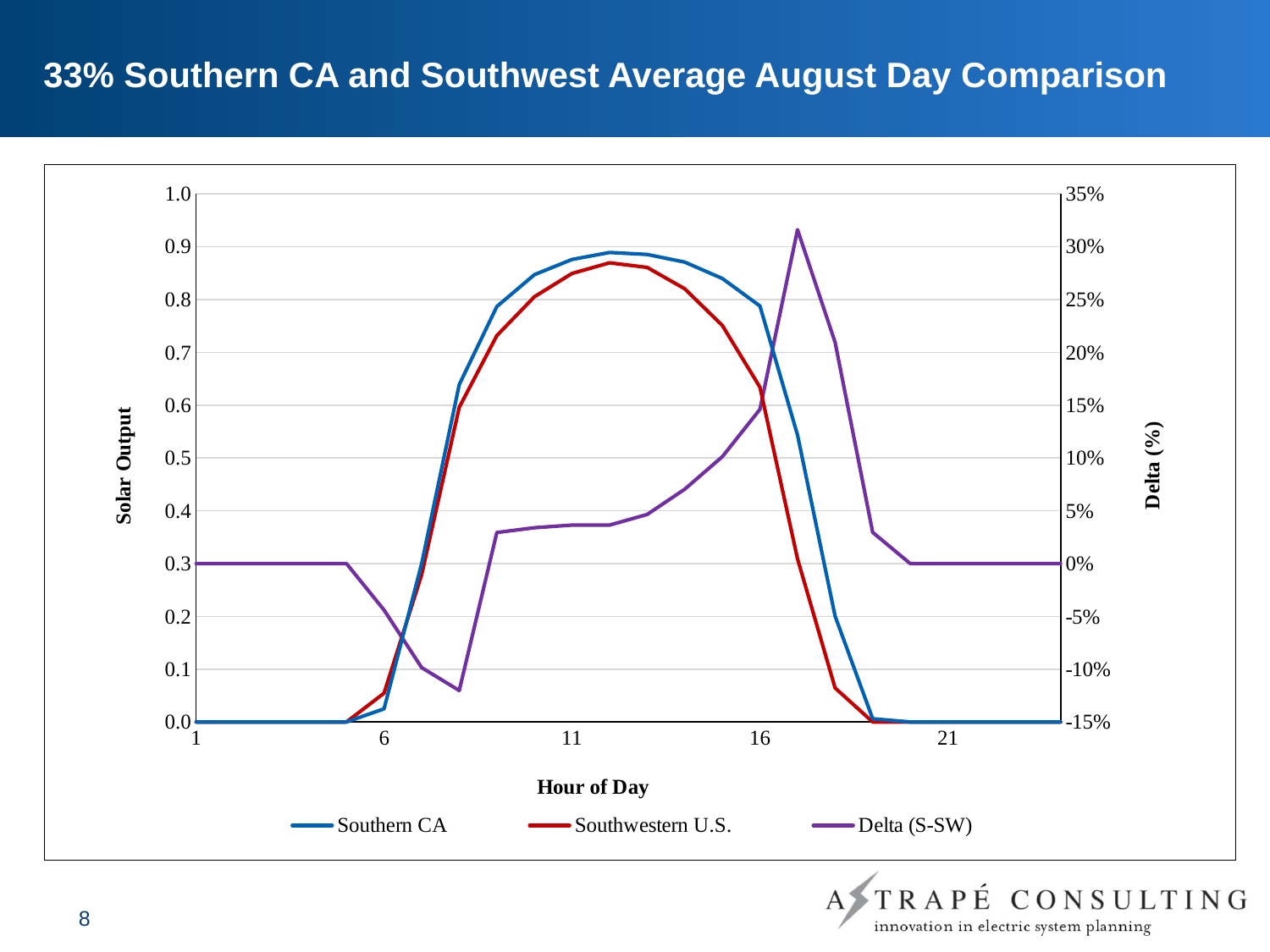
Is the Southwestern U.S. value at hour 16 greater or less than 0.7? less Does the Southern CA series rise or fall between hour 16 and hour 21? fall Does the Delta (S-SW) series rise or fall between hour 13 and hour 17? rise What is the title of the x axis? Hour of Day Is the Delta (S-SW) value at hour 8 greater or less than -10%? less Is the Delta (S-SW) value at hour 17 greater or less than 25%? greater What is the title of the right-hand y axis? Delta (%) How many series does the legend list? 3 At hour 6, which series has the higher solar output, Southern CA or Southwestern U.S.? Southwestern U.S. What kind of chart is shown on the slide? line chart At hour 16, which series has the higher solar output, Southern CA or Southwestern U.S.? Southern CA